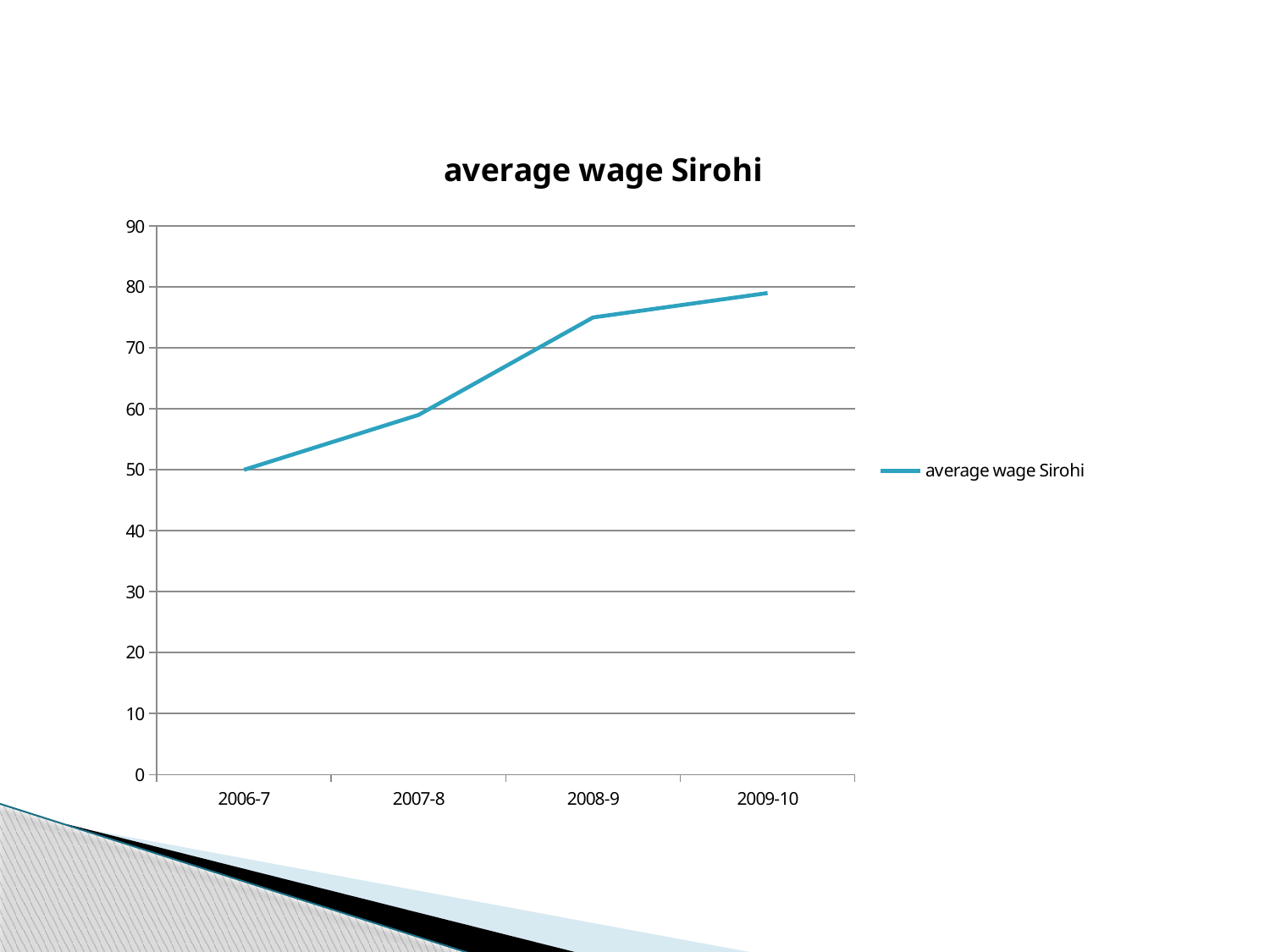
What kind of chart is shown on the slide? line chart Is the value for 2007-8 greater or less than 50? greater Which year has the larger average wage, 2007-8 or 2008-9? 2008-9 Is the value for 2008-9 greater or less than 70? greater Do the values rise or fall from 2006-7 to 2009-10? rise How many years are plotted along the x axis? 4 Which year has the lowest average wage? 2006-7 How many series does the legend list? 1 What is the average wage for 2006-7? 50 Which year has the highest average wage? 2009-10 What is the title of the chart? average wage Sirohi